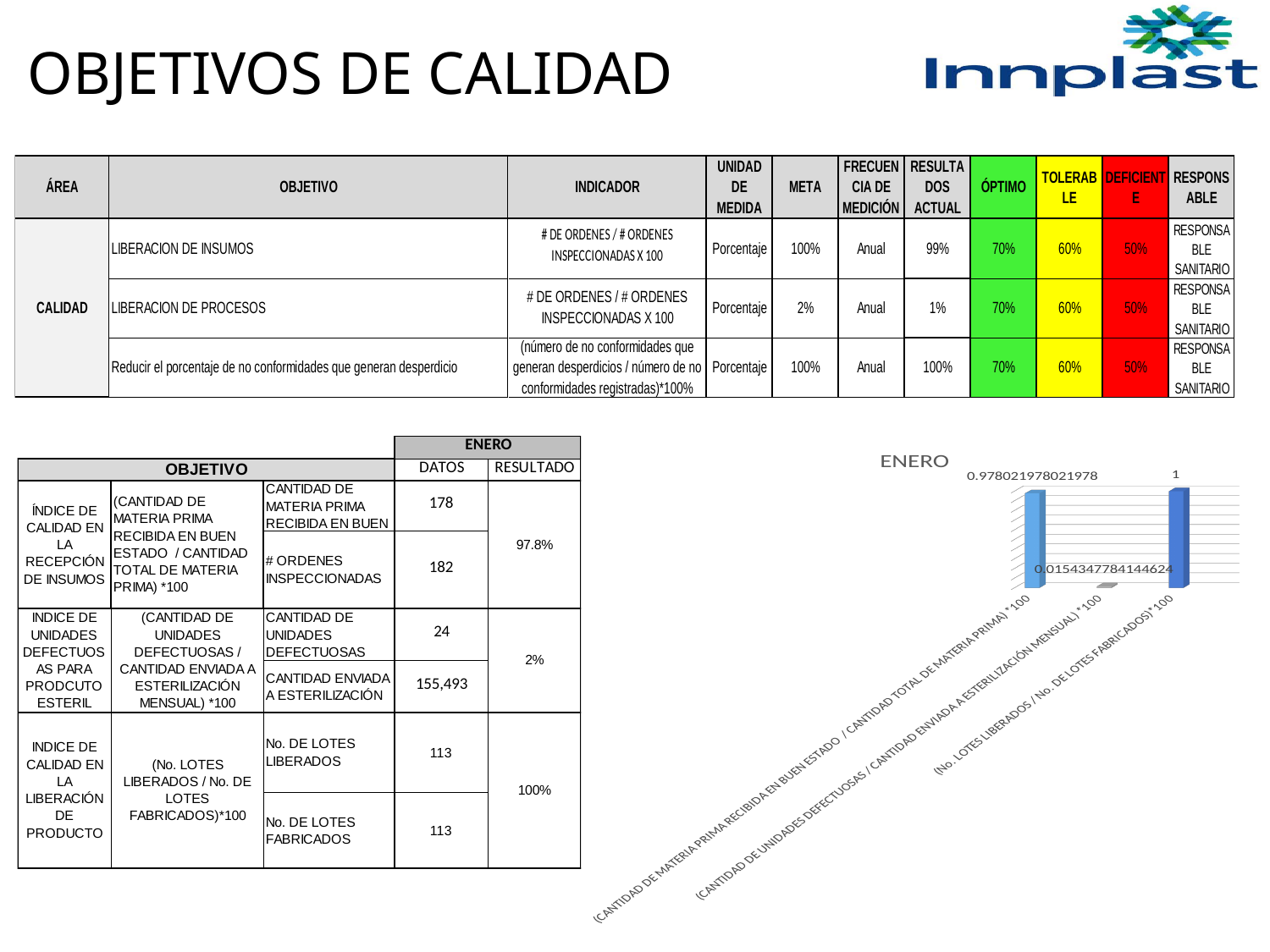
In the ENERO chart, what is the value labelled on the bar for (No. LOTES LIBERADOS / No. DE LOTES FABRICADOS)*100? 1 In the ENERO chart, which is larger: the value for (No. LOTES LIBERADOS / No. DE LOTES FABRICADOS)*100 or the value for (CANTIDAD DE MATERIA PRIMA RECIBIDA EN BUEN ESTADO / CANTIDAD TOTAL DE MATERIA PRIMA) *100? (No. LOTES LIBERADOS / No. DE LOTES FABRICADOS)*100 In the ENERO chart, which is larger: the value for (CANTIDAD DE MATERIA PRIMA RECIBIDA EN BUEN ESTADO / CANTIDAD TOTAL DE MATERIA PRIMA) *100 or the value for (CANTIDAD DE UNIDADES DEFECTUOSAS / CANTIDAD ENVIADA A ESTERILIZACIÓN MENSUAL) *100? (CANTIDAD DE MATERIA PRIMA RECIBIDA EN BUEN ESTADO / CANTIDAD TOTAL DE MATERIA PRIMA) *100 What is the title of the chart on the right side of the slide? ENERO In the ENERO chart, what is the value labelled on the bar for (CANTIDAD DE UNIDADES DEFECTUOSAS / CANTIDAD ENVIADA A ESTERILIZACIÓN MENSUAL) *100? 0.0154347784144624 What kind of chart is shown on the right side of the slide? bar chart In the ENERO chart, what is the difference between the value for (No. LOTES LIBERADOS / No. DE LOTES FABRICADOS)*100 and the value for (CANTIDAD DE MATERIA PRIMA RECIBIDA EN BUEN ESTADO / CANTIDAD TOTAL DE MATERIA PRIMA) *100? 0.021978021978022 In the ENERO chart, which category has the highest value? (No. LOTES LIBERADOS / No. DE LOTES FABRICADOS)*100 In the ENERO chart, what is the value labelled on the bar for (CANTIDAD DE MATERIA PRIMA RECIBIDA EN BUEN ESTADO / CANTIDAD TOTAL DE MATERIA PRIMA) *100? 0.978021978021978 In the ENERO chart, which category has the lowest value? (CANTIDAD DE UNIDADES DEFECTUOSAS / CANTIDAD ENVIADA A ESTERILIZACIÓN MENSUAL) *100 How many bars are plotted in the ENERO chart? 3